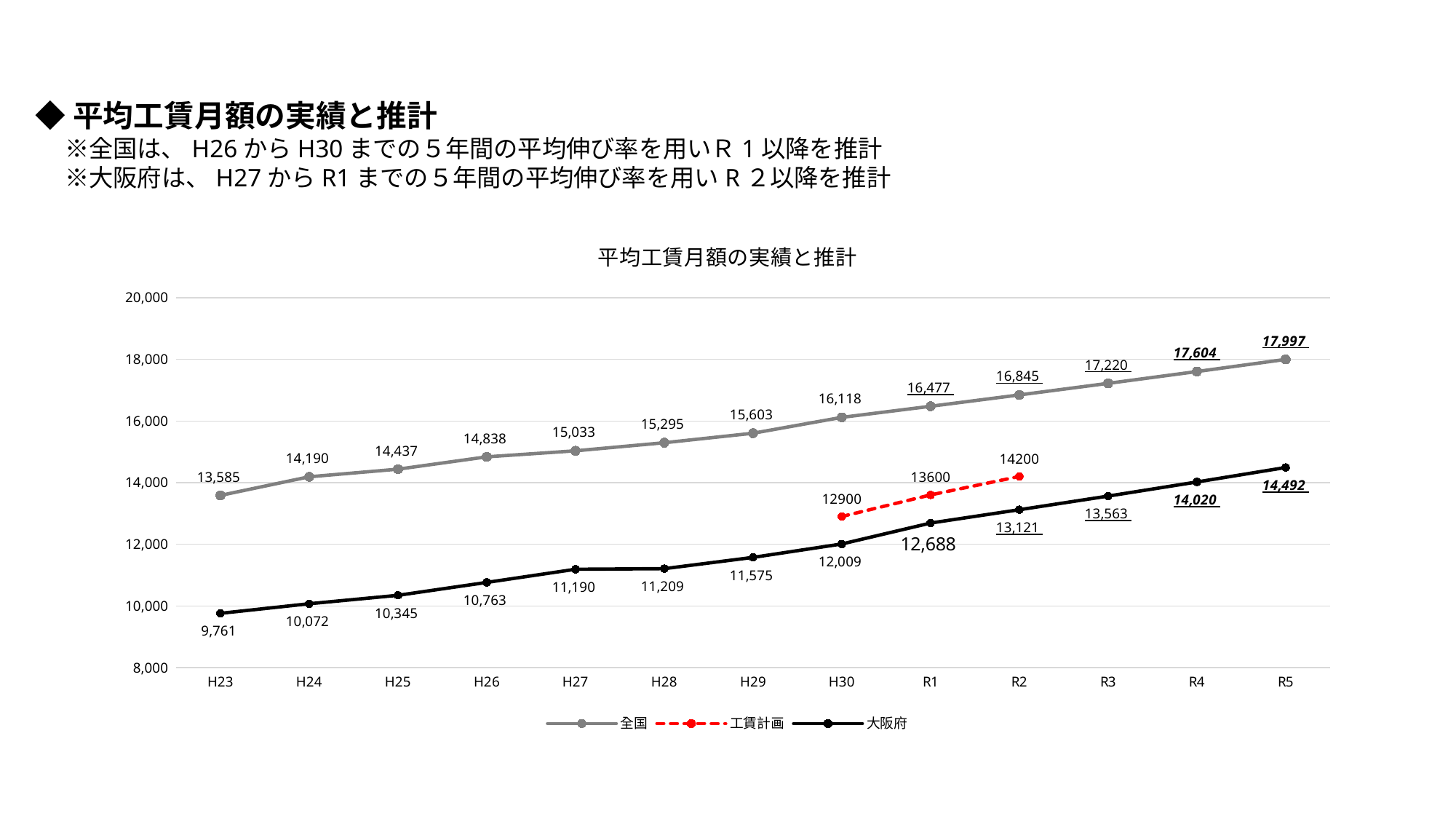
Which is larger in R2, 工賃計画 or 大阪府? 工賃計画 What is the difference between 全国 and 大阪府 in R5? 3,505 How many years are shown on the x axis? 13 What is the value for 大阪府 in H30? 12,009 Does the 大阪府 series rise or fall from H23 to R5? rise What is the value for 工賃計画 in R1? 13600 How many series does the legend list? 3 In which year is the 全国 series highest? R5 In which year is the 大阪府 series lowest? H23 What kind of chart is this? line chart What is the value for 大阪府 in R5? 14,492 What is the value for 全国 in H23? 13,585